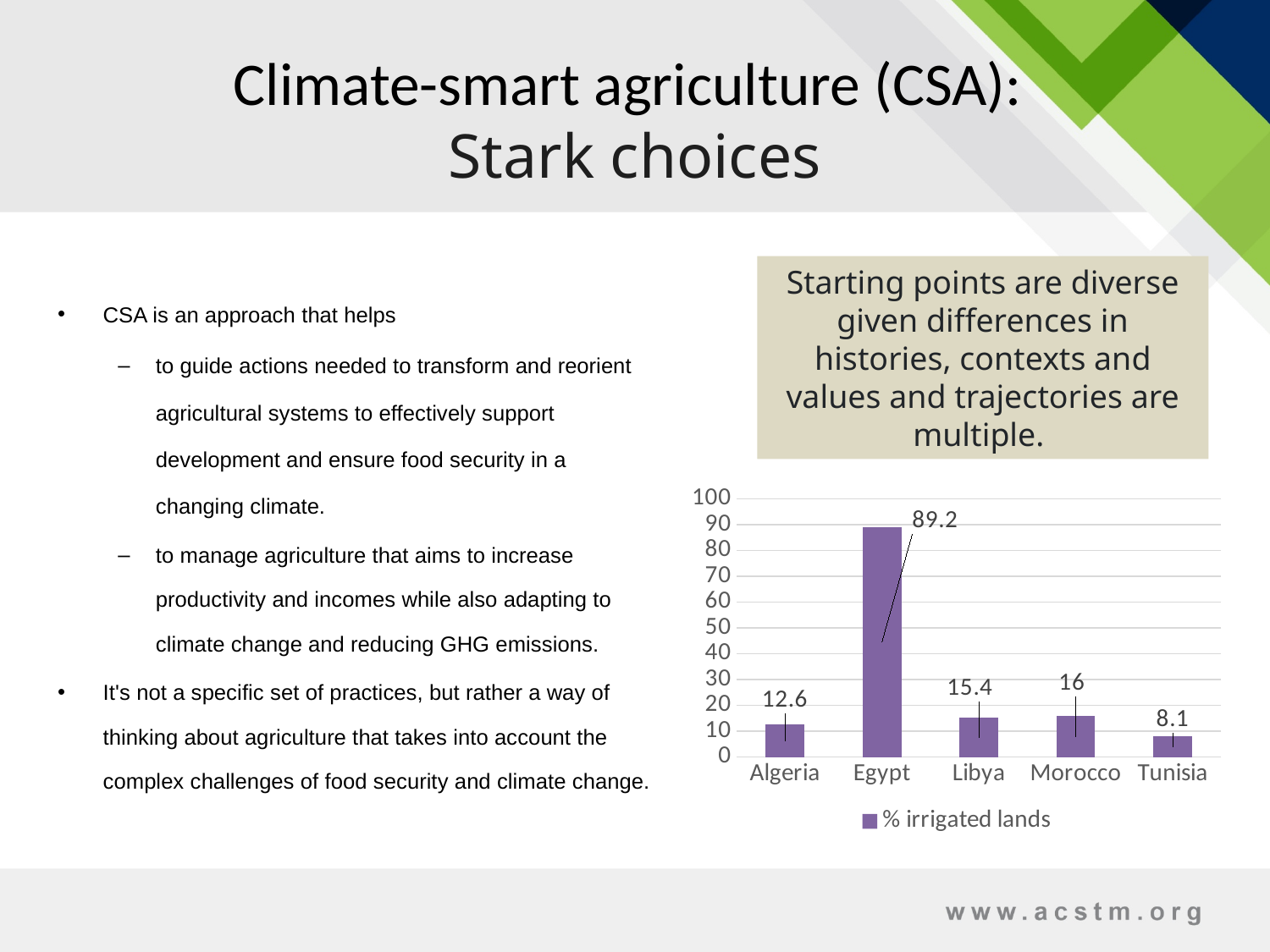
What is the % irrigated lands value for Morocco? 16 What is the % irrigated lands value for Tunisia? 8.1 Which country has the highest % irrigated lands? Egypt How many countries are shown in the chart? 5 What is the difference in % irrigated lands between Egypt and Libya? 73.8 What type of chart is shown on the slide? Bar chart Which has a higher % irrigated lands, Algeria or Libya? Libya Is the value for Egypt greater or less than 80? greater What series name is shown in the chart legend? % irrigated lands What is the % irrigated lands value for Egypt? 89.2 What is the % irrigated lands value for Algeria? 12.6 Which country has the lowest % irrigated lands? Tunisia